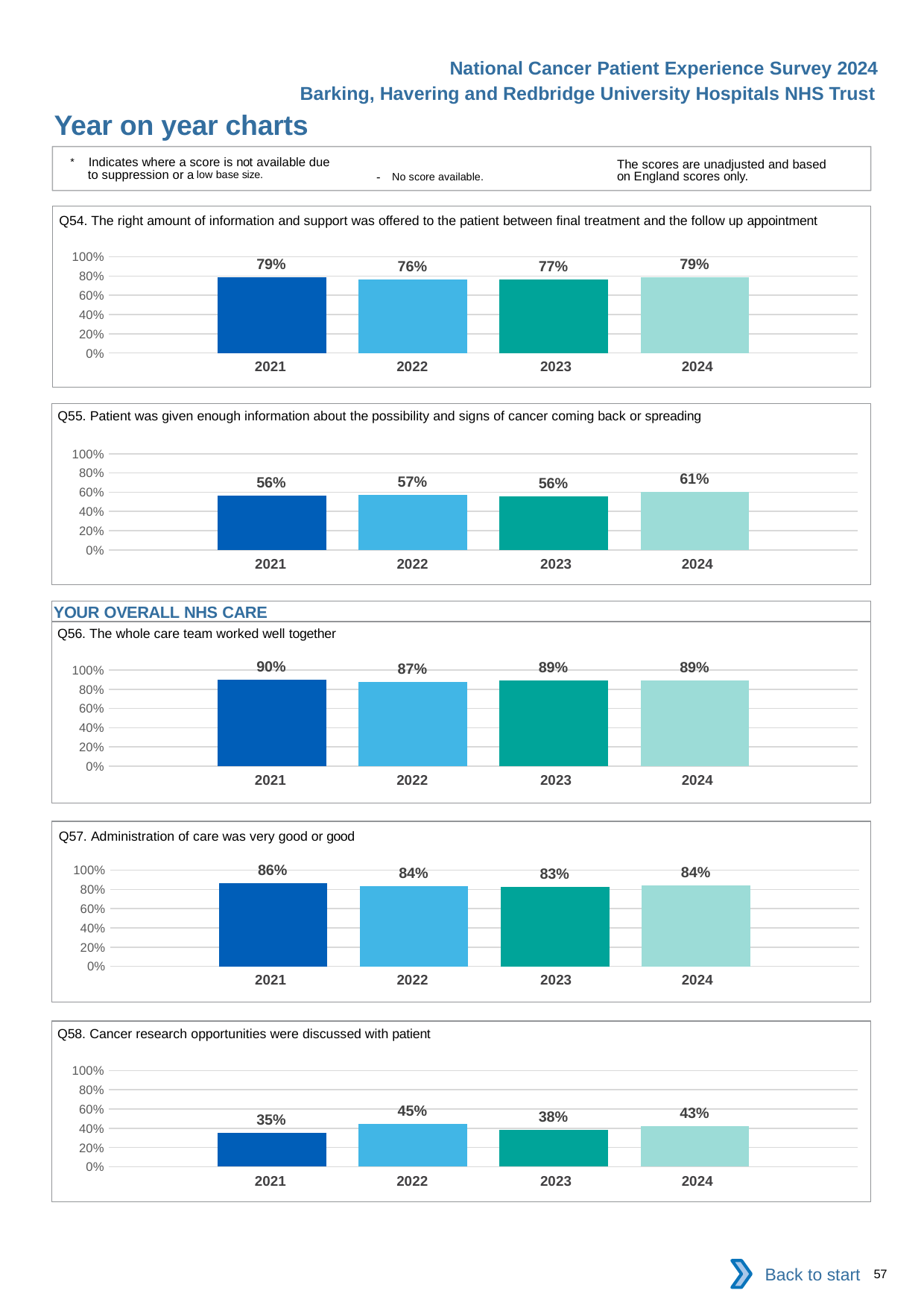
What kind of chart is the Q55 chart? bar chart How many years are shown on the x axis of the Q54 chart? 4 In the Q54 chart, what is the value for 2022? 76% In the Q56 chart, what is the value for 2021? 90% In the Q57 chart, what is the difference between the 2021 and 2023 values? 3% In the Q57 chart, which is larger, the value for 2021 or the value for 2023? 2021 In the Q55 chart, which year has the highest value? 2024 In the Q58 chart, what is the value for 2023? 38% In the Q56 chart, which year has the lowest value? 2022 In the Q58 chart, is the value for 2021 greater or less than 40%? less In the Q58 chart, which year has the highest value? 2022 In the Q55 chart, what is the difference between the 2024 and 2023 values? 5%